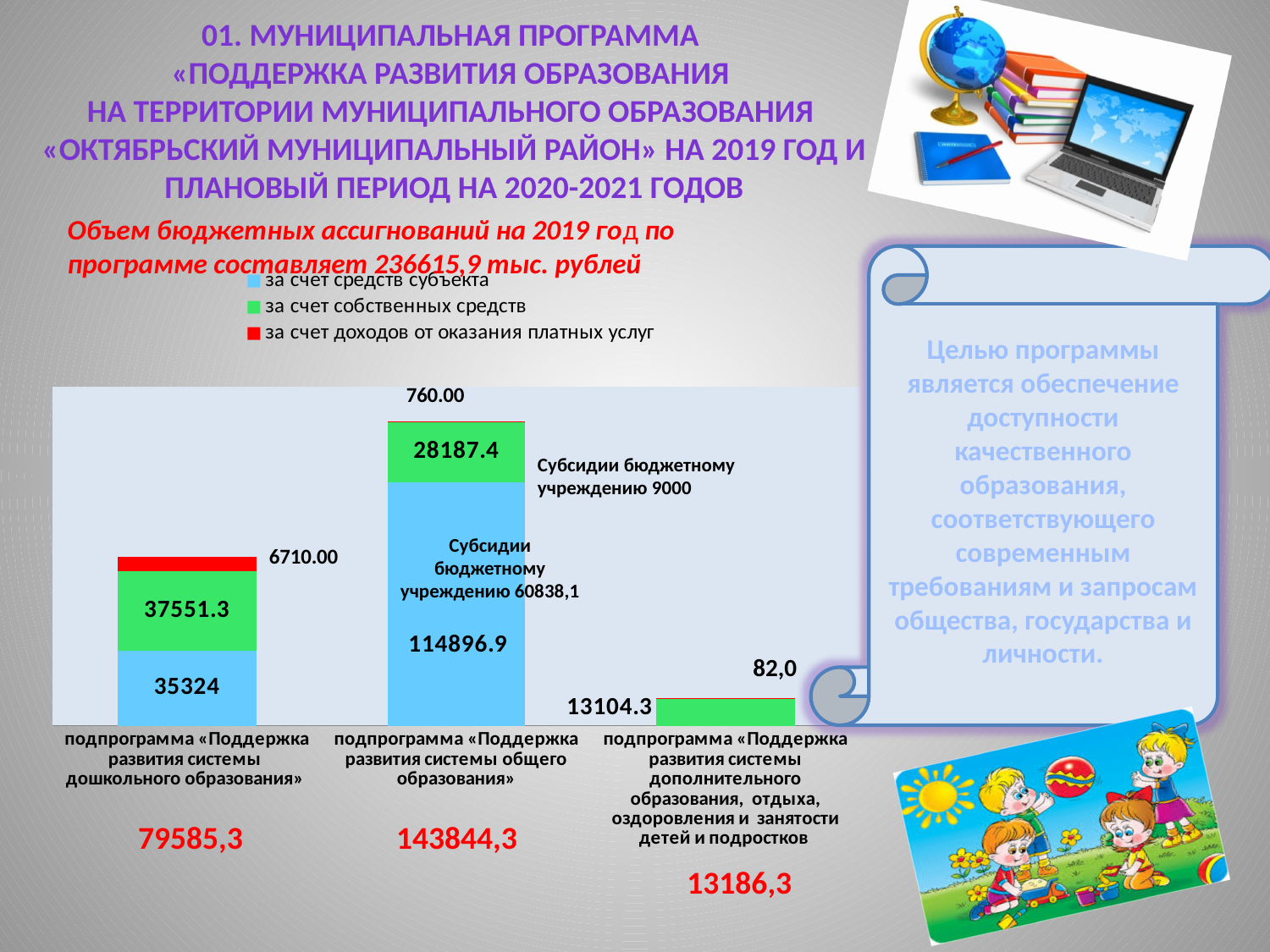
What is the value for «за счет доходов от оказания платных услуг» in the subprogram «Поддержка развития системы дошкольного образования»? 6710.00 What is the value for «за счет средств субъекта» in the subprogram «Поддержка развития системы дошкольного образования»? 35324 Which subprogram has the lowest total bar? подпрограмма «Поддержка развития системы дополнительного образования, отдыха, оздоровления и занятости детей и подростков» What colour represents «за счет доходов от оказания платных услуг» in the chart? red What is the total of the stacked bar for the subprogram «Поддержка развития системы общего образования»? 143844,3 How many subprograms (categories) are shown on the chart? 3 What kind of chart is shown on the slide? stacked bar chart What is the value for «за счет собственных средств» in the subprogram «Поддержка развития системы дополнительного образования, отдыха, оздоровления и занятости детей и подростков»? 13104.3 What is the value for «за счет собственных средств» in the subprogram «Поддержка развития системы общего образования»? 28187.4 How many series does the chart legend list? 3 Which is larger: «за счет средств субъекта» for the subprogram «Поддержка развития системы общего образования» or for the subprogram «Поддержка развития системы дошкольного образования»? подпрограмма «Поддержка развития системы общего образования» Which subprogram has the highest total bar? подпрограмма «Поддержка развития системы общего образования»